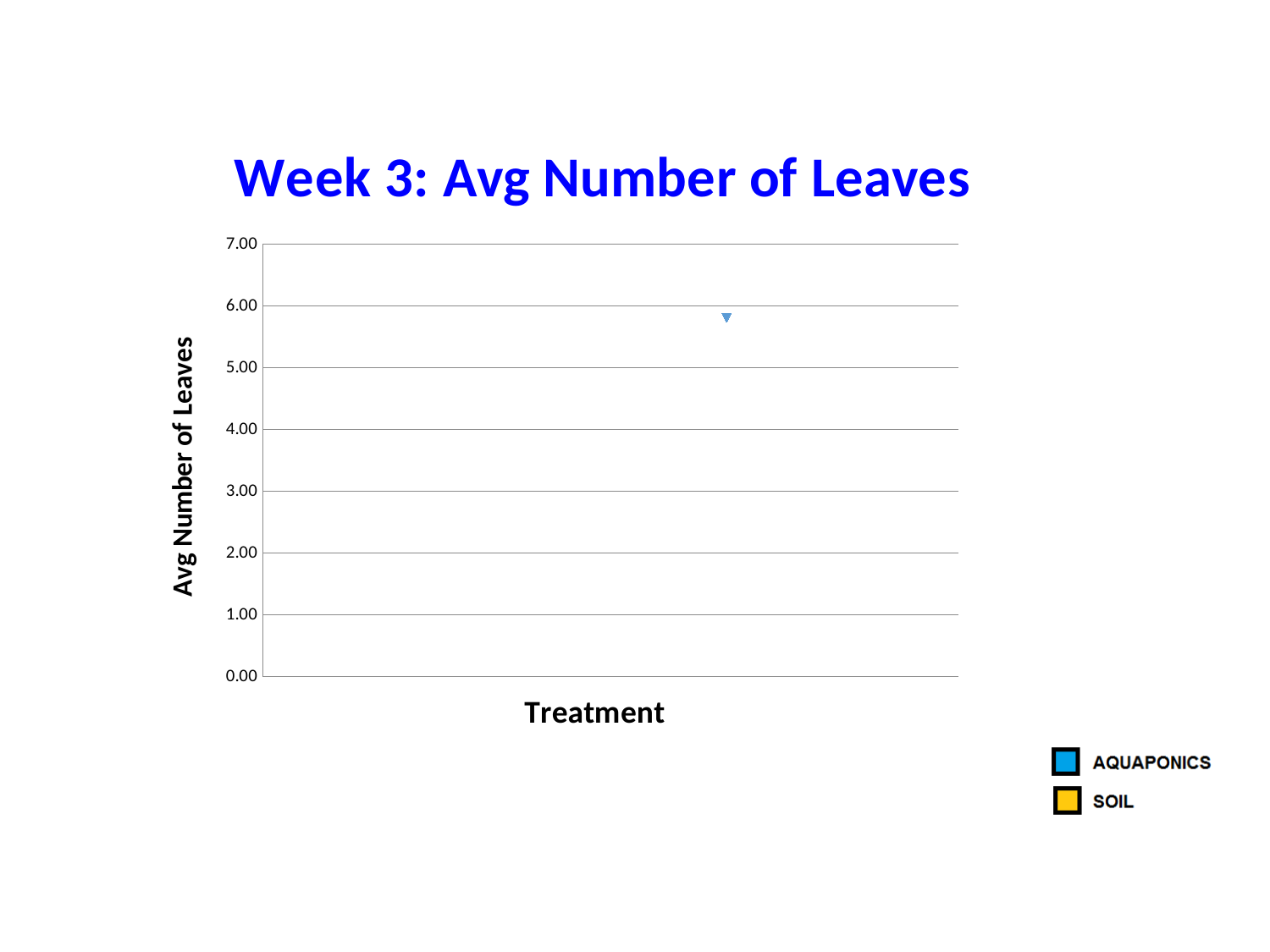
Is the value of the plotted point greater or less than 3.00? greater What is the title of the chart? Week 3: Avg Number of Leaves Is the value of the plotted point greater or less than 6.00? less How many data points are plotted on the chart? 1 How many entries does the legend on the slide list? 2 What is the highest value shown on the y axis? 7.00 Is the value of the plotted point greater or less than 5.00? greater What is the label of the x axis? Treatment